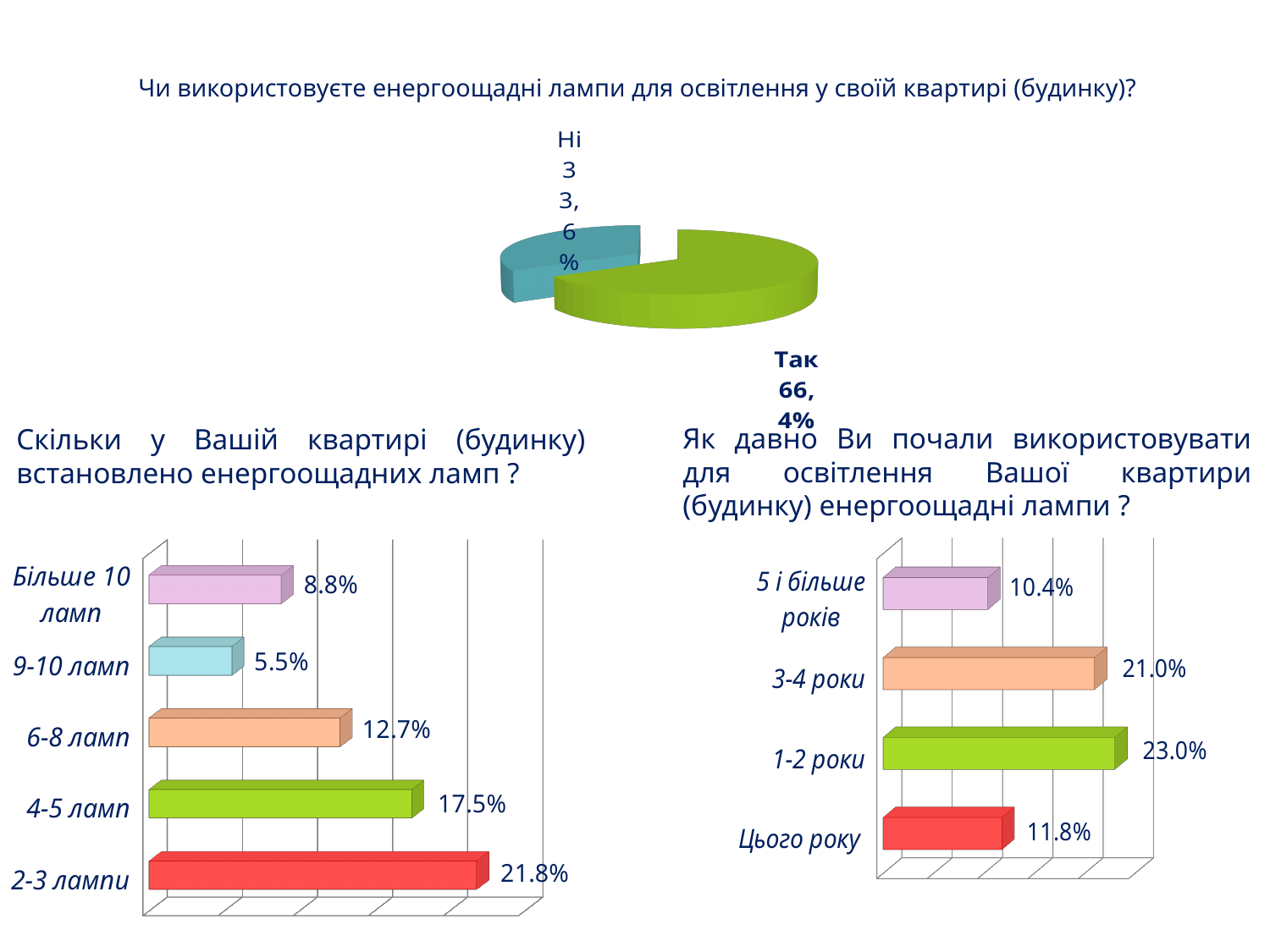
In the bottom-left bar chart (number of energy-saving lamps installed), what is the value for "2-3 лампи"? 21.8% How many categories are shown in the bottom-left bar chart (number of energy-saving lamps installed)? 5 In the bottom-right bar chart (how long energy-saving lamps have been used), which category has the highest value? 1-2 роки What kind of chart is shown at the top of the slide? Pie chart In the bottom-right bar chart (how long energy-saving lamps have been used), which is larger: "Цього року" or "5 і більше років"? Цього року In the bottom-left bar chart (number of energy-saving lamps installed), what is the difference between "4-5 ламп" and "6-8 ламп"? 4.8% In the pie chart at the top of the slide, what share of respondents answered "Ні"? 33,6% What kind of chart is shown at the bottom right of the slide? Bar chart In the bottom-left bar chart (number of energy-saving lamps installed), which category has the lowest value? 9-10 ламп In the bottom-right bar chart (how long energy-saving lamps have been used), what is the difference between "1-2 роки" and "Цього року"? 11.2% In the pie chart at the top of the slide, what share of respondents answered "Так"? 66,4% In the bottom-right bar chart (how long energy-saving lamps have been used), what is the value for "3-4 роки"? 21.0%